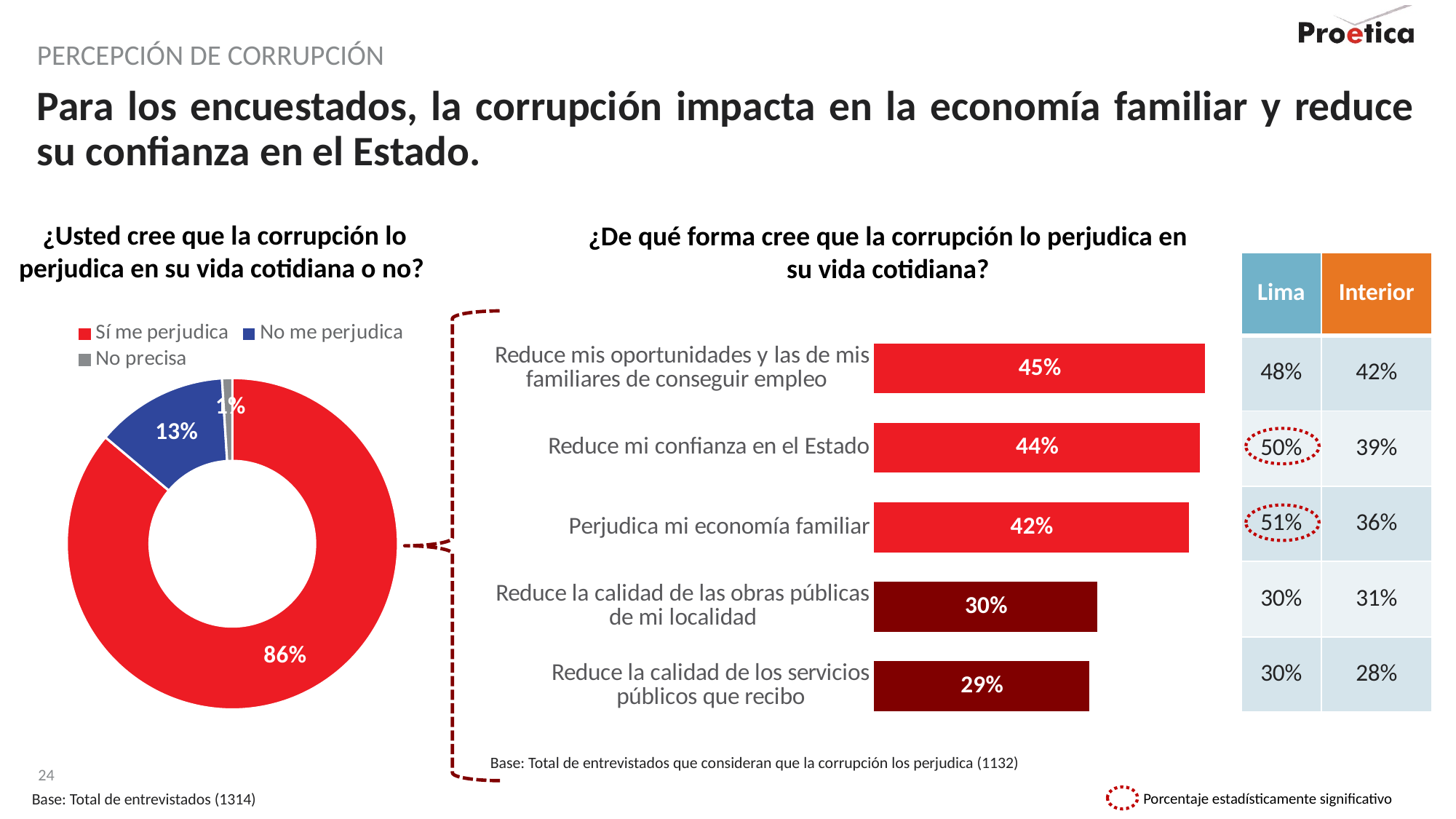
In the bar chart on the right, what is the difference between 'Perjudica mi economía familiar' and 'Reduce la calidad de las obras públicas de mi localidad'? 12 percentage points In the bar chart on the right, what is the value for 'Reduce la calidad de los servicios públicos que recibo'? 29% In the bar chart on the right, which category has the lowest value? Reduce la calidad de los servicios públicos que recibo In the bar chart on the right, which category has the highest value? Reduce mis oportunidades y las de mis familiares de conseguir empleo In the bar chart on the right, what is the value for 'Reduce mi confianza en el Estado'? 44% In the donut chart on the left, what percentage of respondents answered 'No me perjudica'? 13% In the donut chart on the left, what is the difference between 'Sí me perjudica' and 'No me perjudica'? 73 percentage points In the donut chart on the left, how many categories does the legend list? 3 In the donut chart on the left, what percentage corresponds to 'No precisa'? 1% What type of chart is used for the question '¿De qué forma cree que la corrupción lo perjudica en su vida cotidiana?'? Bar chart In the bar chart on the right, how many categories are plotted? 5 In the donut chart on the left, what percentage of respondents answered 'Sí me perjudica'? 86%